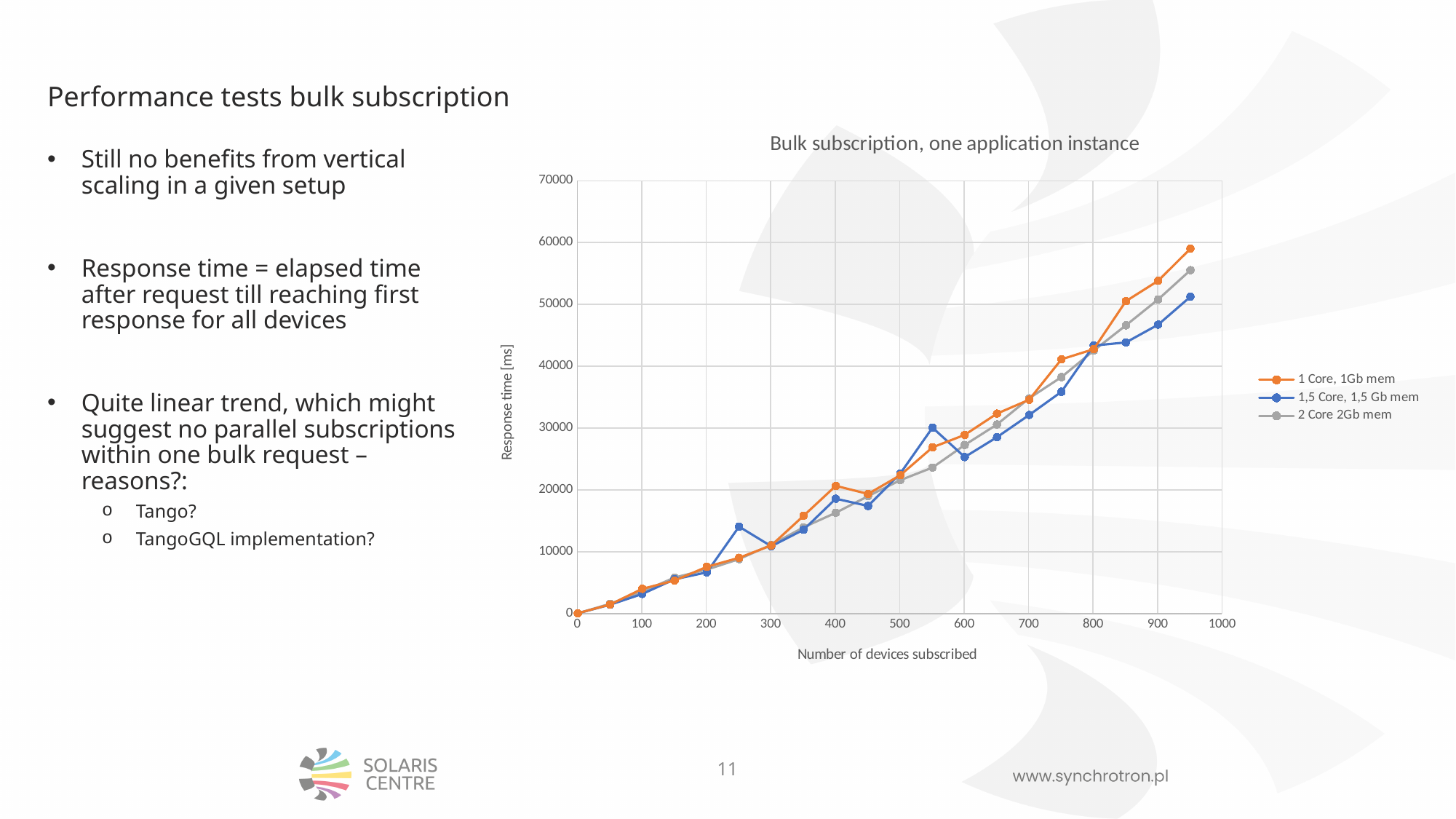
Is the response time for 1 Core, 1Gb mem at 950 devices greater or less than 50000? greater What is the title of the chart? Bulk subscription, one application instance Is the response time for 1,5 Core, 1,5 Gb mem at 250 devices greater or less than 10000? greater Which series has the highest response time at 950 devices subscribed? 1 Core, 1Gb mem Do the response times rise or fall as the number of devices subscribed increases? Rise Is the response time for 1,5 Core, 1,5 Gb mem at 950 devices greater or less than 60000? less How many series does the legend list? 3 At 250 devices subscribed, which series has the higher response time: 1,5 Core, 1,5 Gb mem or 1 Core, 1Gb mem? 1,5 Core, 1,5 Gb mem What is the label of the y axis? Response time [ms] What kind of chart is shown on the slide? Line chart Which series has the lowest response time at 950 devices subscribed? 1,5 Core, 1,5 Gb mem